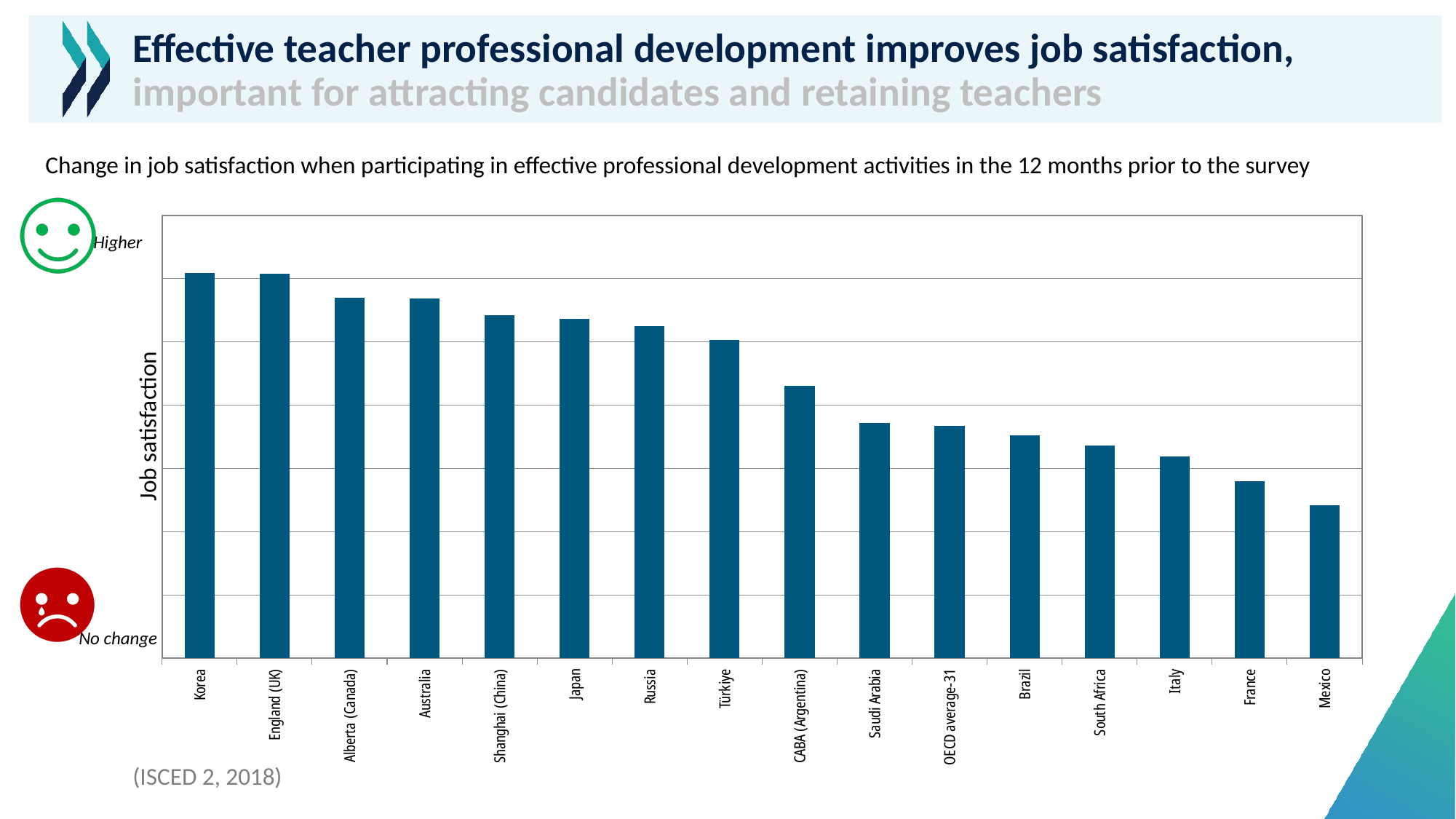
Which has the larger change in job satisfaction, Japan or Brazil? Japan Which country has the lowest change in job satisfaction on the chart? Mexico Which has the larger change in job satisfaction, CABA (Argentina) or Shanghai (China)? Shanghai (China) What kind of chart is shown on the slide? Bar chart Do the bars rise or fall moving from left to right along the x axis? Fall Which has the larger change in job satisfaction, Italy or Australia? Australia What is the label on the vertical axis of the chart? Job satisfaction How many countries or economies are shown on the x axis of the chart? 16 What is the chart's title as written above it? Change in job satisfaction when participating in effective professional development activities in the 12 months prior to the survey